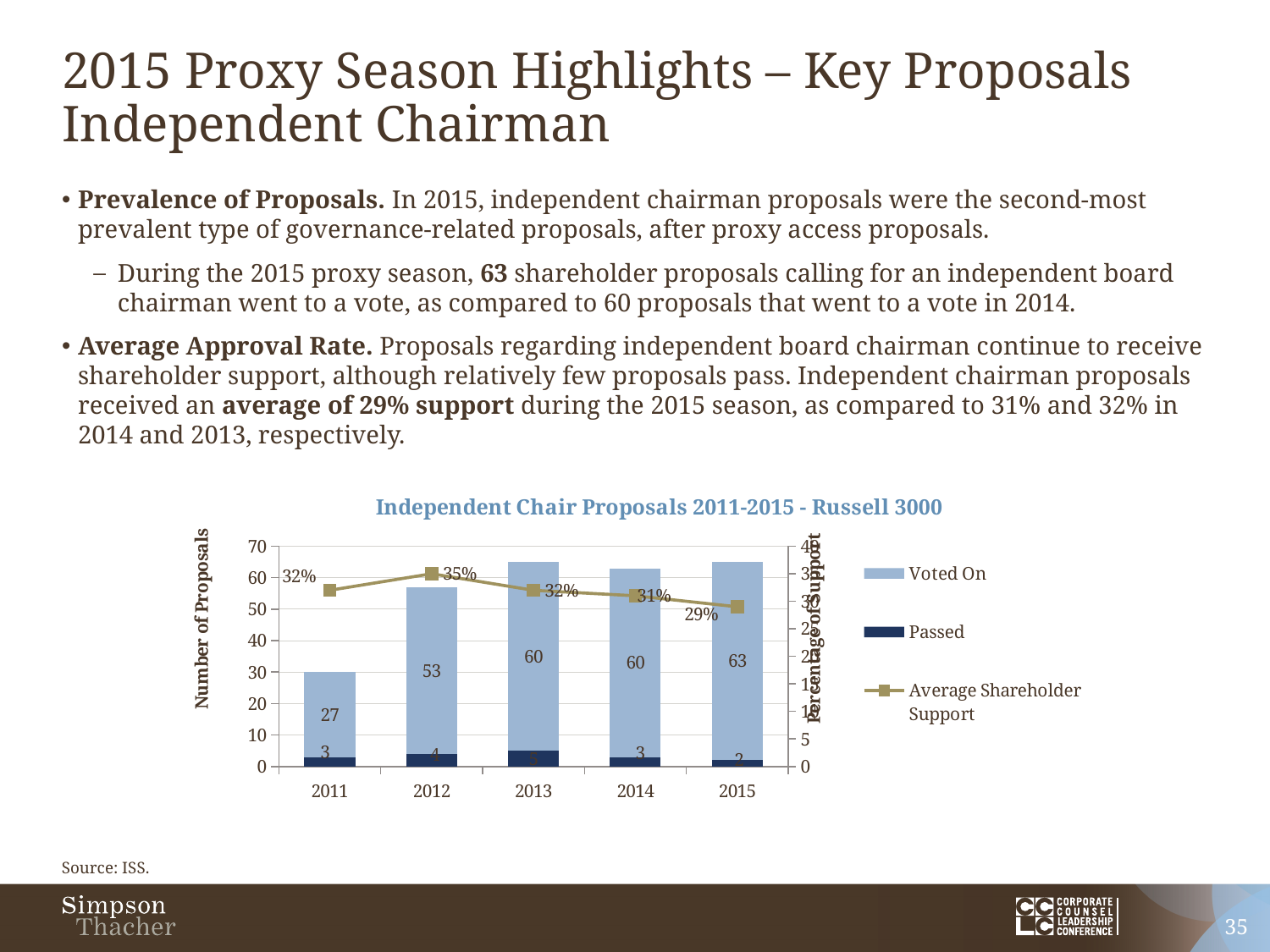
What is the Voted On value for 2015? 63 What is the difference between the Voted On values for 2012 and 2011? 26 Which year has the highest Voted On value? 2015 Which year has the lowest Average Shareholder Support? 2015 How many series does the legend list? 3 What is the Average Shareholder Support for 2012? 35% How many proposals were Passed in 2014? 3 Does the Average Shareholder Support line rise or fall from 2012 to 2015? fall How many years are shown on the x axis? 5 What is the total height of the stacked bar for 2011 (Voted On plus Passed)? 30 Is the Voted On value larger in 2015 or in 2012? 2015 Which year has the lowest Voted On value? 2011